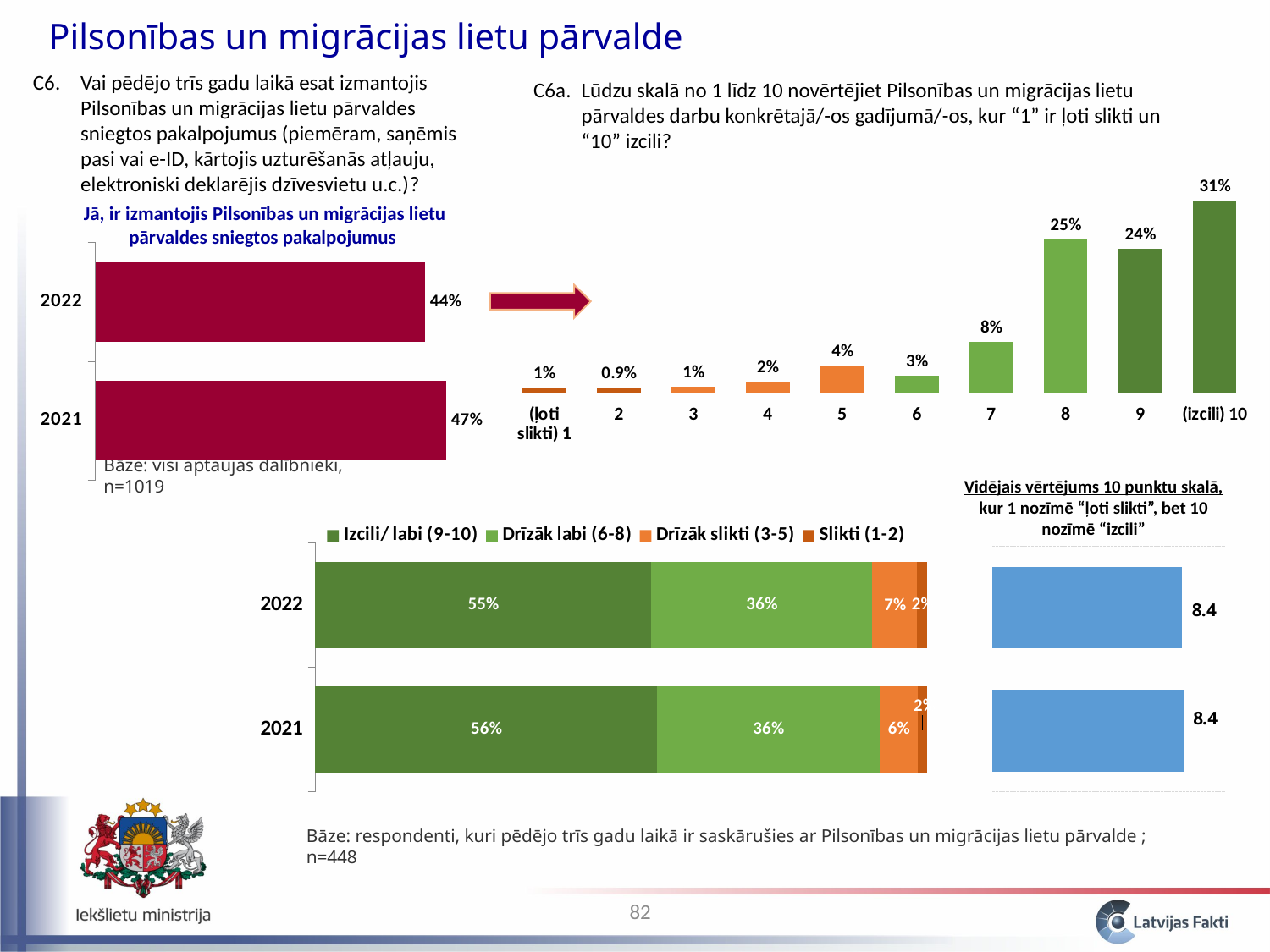
In the top-right bar chart for question C6a (scale 1 to 10), what is the value for rating 2? 0.9% In the top-left bar chart titled "Jā, ir izmantojis Pilsonības un migrācijas lietu pārvaldes sniegtos pakalpojumus", what is the value for 2021? 47% In the top-right bar chart for question C6a (scale 1 to 10), which rating has the highest value? (izcili) 10 In the top-left bar chart titled "Jā, ir izmantojis Pilsonības un migrācijas lietu pārvaldes sniegtos pakalpojumus", what is the value for 2022? 44% How many rating categories are shown in the top-right bar chart for question C6a? 10 In the bottom stacked bar chart, what is the value of "Izcili/ labi (9-10)" for 2021? 56% In the top-right bar chart for question C6a (scale 1 to 10), what is the value for rating 8? 25% In the top-left bar chart, what is the difference between the 2021 and 2022 values? 3% In the top-left bar chart, which year has the higher value, 2021 or 2022? 2021 How many series does the legend of the bottom stacked bar chart list? 4 In the bottom-right chart "Vidējais vērtējums 10 punktu skalā", what is the average rating for 2022? 8.4 In the bottom stacked bar chart, what is the value of "Drīzāk slikti (3-5)" for 2022? 7%